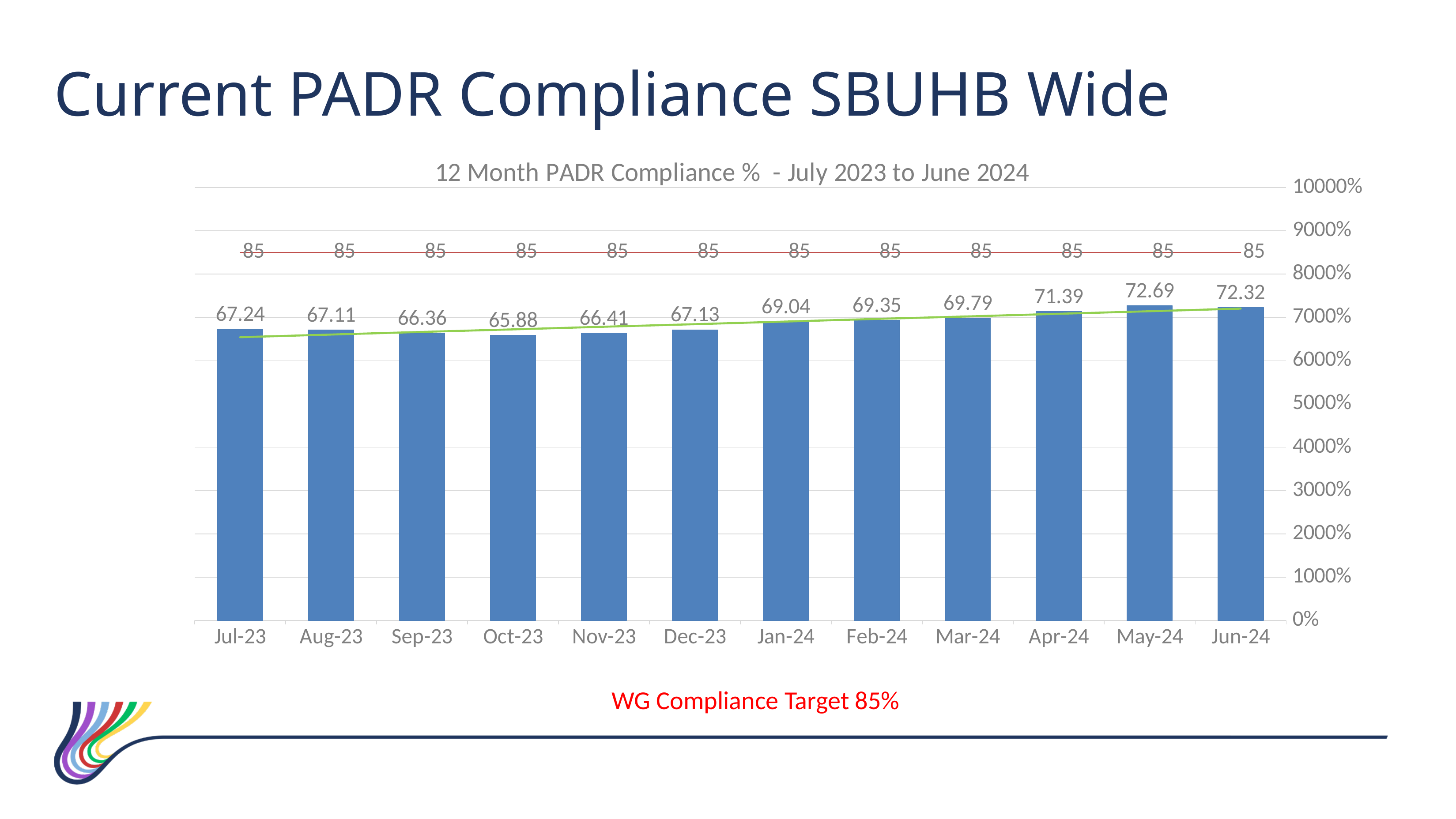
What kind of chart is used to show the monthly PADR compliance values? Bar chart What is the PADR compliance value for Jun-24? 72.32 What is the PADR compliance value for Oct-23? 65.88 Which month has the lowest PADR compliance value? Oct-23 What target value is shown by the red line across the chart? 85 How many months are shown on the x axis of the chart? 12 Which month has the highest PADR compliance value? May-24 What is the PADR compliance value for Apr-24? 71.39 Do the PADR compliance values generally rise or fall from Jul-23 to Jun-24? Rise Which is larger, the value for Dec-23 or the value for Jan-24? Jan-24 What is the PADR compliance value for Jul-23? 67.24 What is the difference between the Jun-24 value and the Jul-23 value? 5.08